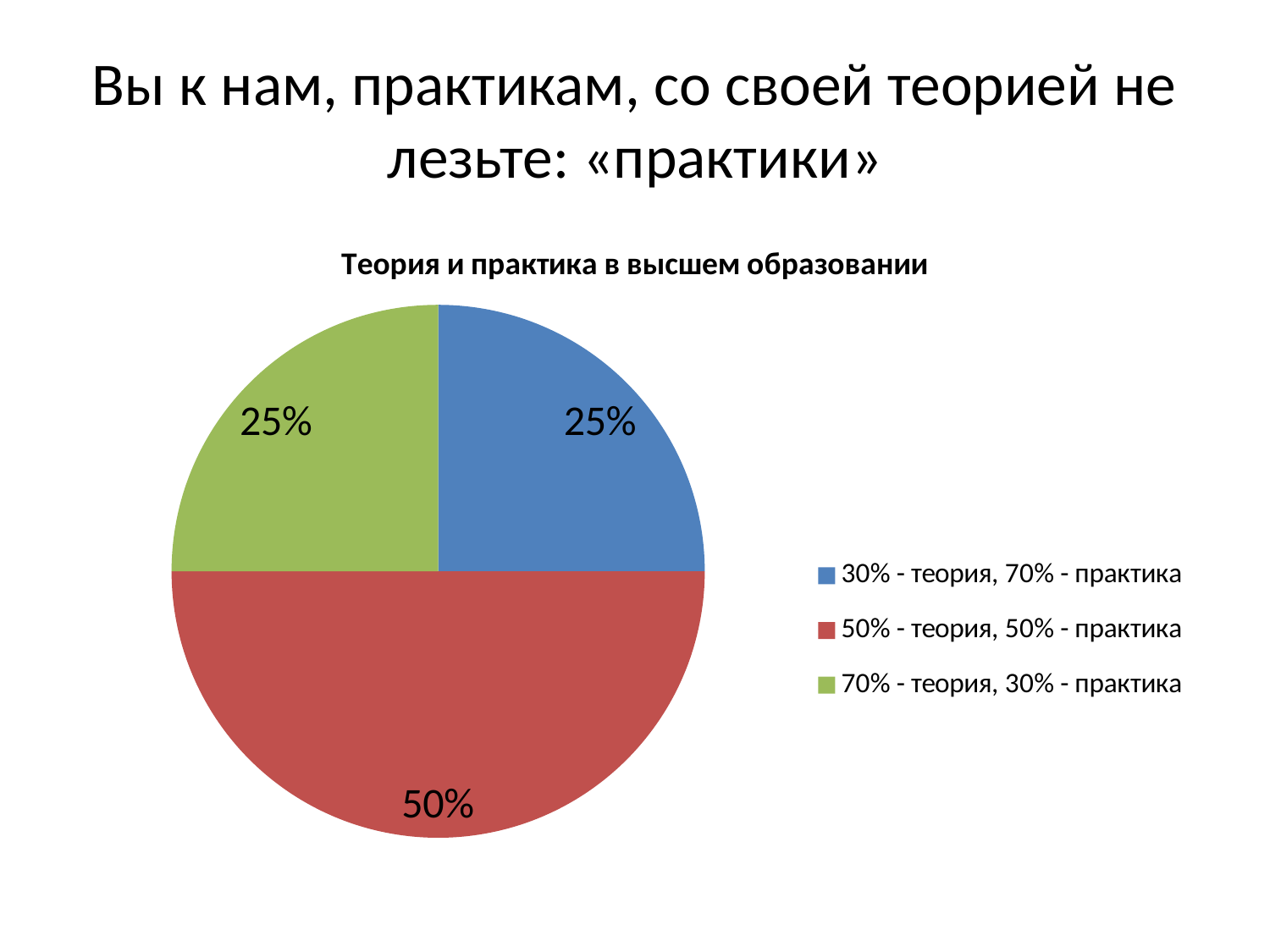
What share of the pie is the slice for "70% - теория, 30% - практика"? 25% What share of the pie is the slice for "30% - теория, 70% - практика"? 25% How many slices does the pie chart have? 3 What share of the pie is the slice for "50% - теория, 50% - практика"? 50% What kind of chart is shown on the slide? pie chart Which category has the largest slice of the pie? 50% - теория, 50% - практика How many entries does the legend list? 3 What is the difference between the share for "50% - теория, 50% - практика" and the share for "30% - теория, 70% - практика"? 25% Which is larger: the slice for "50% - теория, 50% - практика" or the slice for "70% - теория, 30% - практика"? 50% - теория, 50% - практика What is the title of the chart? Теория и практика в высшем образовании What colour is the slice for "50% - теория, 50% - практика"? red